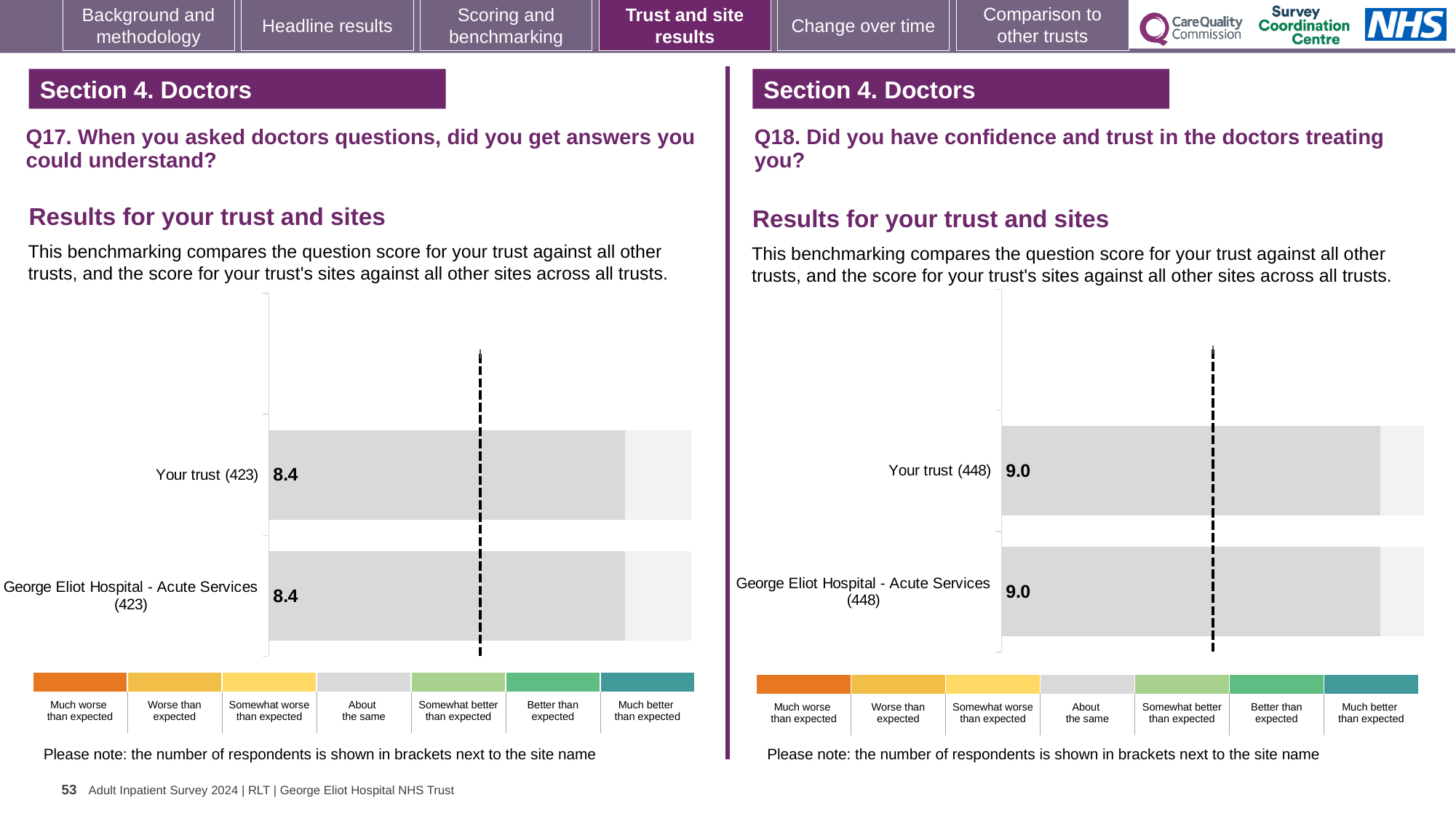
On the Q17 chart (left), what is the difference between the score for Your trust and the score for George Eliot Hospital - Acute Services? 0.0 On the Q18 chart (right), what is the score for Your trust? 9.0 On the Q18 chart (right), what is the difference between the score for Your trust and the score for George Eliot Hospital - Acute Services? 0.0 On the Q17 chart (left), what is the score for Your trust? 8.4 On the Q18 chart (right), how many respondents are shown in brackets for George Eliot Hospital - Acute Services? 448 On the Q17 chart (left), how many respondents are shown in brackets for Your trust? 423 On the Q18 chart (right), what is the score for George Eliot Hospital - Acute Services? 9.0 Is the score for Your trust on the Q18 chart (right) larger than the score for Your trust on the Q17 chart (left)? Yes What kind of chart is the Q18 chart (right)? Bar chart On the Q17 chart (left), what is the score for George Eliot Hospital - Acute Services? 8.4 How many bars are plotted on the Q17 chart (left)? 2 How many bars are plotted on the Q18 chart (right)? 2